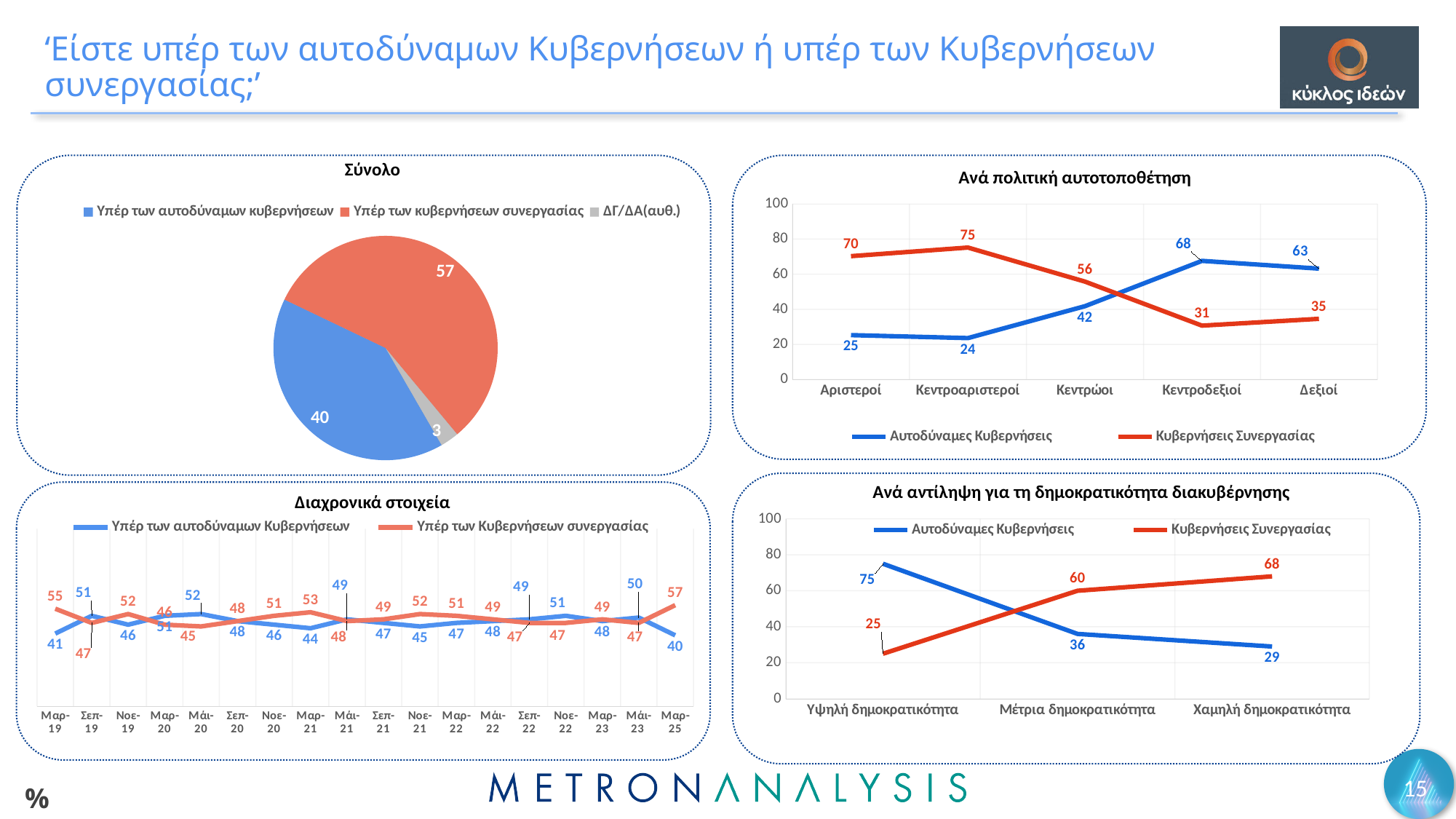
In the 'Σύνολο' pie chart, what share is labelled for 'Υπέρ των κυβερνήσεων συνεργασίας'? 57 In the 'Ανά αντίληψη για τη δημοκρατικότητα διακυβέρνησης' chart, does the 'Αυτοδύναμες Κυβερνήσεις' line rise or fall from left to right? fall In the 'Ανά πολιτική αυτοτοποθέτηση' chart, how many categories are shown on the x axis? 5 In the 'Διαχρονικά στοιχεία' chart, which series is larger at Μαρ-25, 'Υπέρ των αυτοδύναμων Κυβερνήσεων' or 'Υπέρ των Κυβερνήσεων συνεργασίας'? Υπέρ των Κυβερνήσεων συνεργασίας In the 'Ανά πολιτική αυτοτοποθέτηση' chart, what is the value of 'Αυτοδύναμες Κυβερνήσεις' for 'Κεντρώοι'? 42 In the 'Ανά αντίληψη για τη δημοκρατικότητα διακυβέρνησης' chart, what is the value of 'Κυβερνήσεις Συνεργασίας' for 'Μέτρια δημοκρατικότητα'? 60 In the 'Σύνολο' chart, what kind of chart is shown? pie chart In the 'Διαχρονικά στοιχεία' chart, what is the value of 'Υπέρ των Κυβερνήσεων συνεργασίας' for Μαρ-25? 57 In the 'Ανά πολιτική αυτοτοποθέτηση' chart, what is the difference between 'Κυβερνήσεις Συνεργασίας' and 'Αυτοδύναμες Κυβερνήσεις' for 'Αριστεροί'? 45 In the 'Ανά αντίληψη για τη δημοκρατικότητα διακυβέρνησης' chart, how many series does the legend list? 2 In the 'Ανά πολιτική αυτοτοποθέτηση' chart, which category has the highest value for 'Αυτοδύναμες Κυβερνήσεις'? Κεντροδεξιοί In the 'Σύνολο' pie chart, what is the value for 'ΔΓ/ΔΑ(αυθ.)'? 3